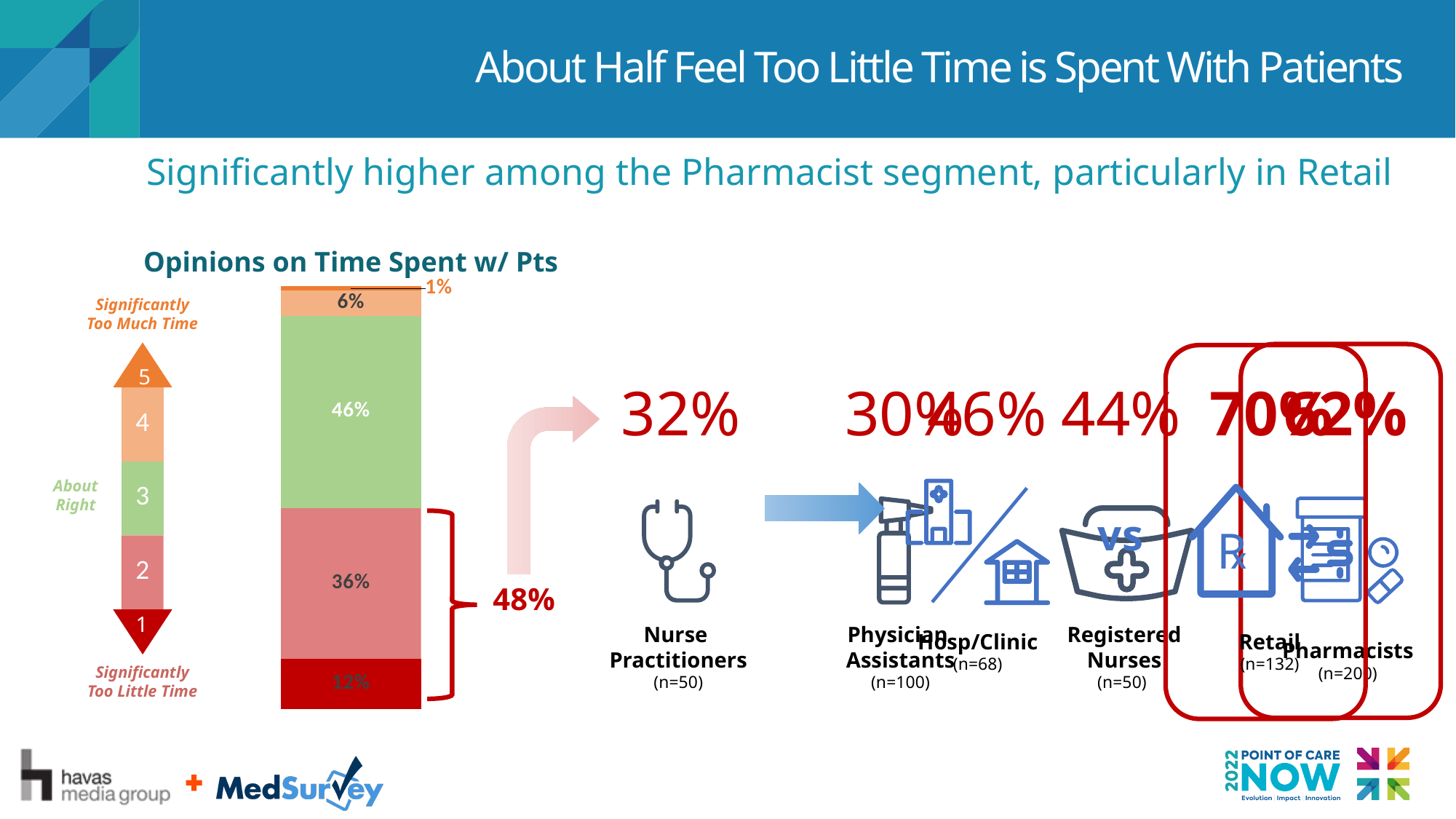
In the 'Opinions on Time Spent w/ Pts' chart, what percentage corresponds to rating 1 (Significantly Too Little Time)? 12% In the 'Opinions on Time Spent w/ Pts' chart, what percentage corresponds to rating 5 (Significantly Too Much Time)? 1% Which rating segment is the smallest in the 'Opinions on Time Spent w/ Pts' chart? Rating 5 (Significantly Too Much Time), 1% What kind of chart is 'Opinions on Time Spent w/ Pts'? Stacked bar chart In the 'Opinions on Time Spent w/ Pts' chart, what percentage corresponds to rating 3 (About Right)? 46% Which rating segment is the largest in the 'Opinions on Time Spent w/ Pts' chart? Rating 3 (About Right), 46% In the 'Opinions on Time Spent w/ Pts' chart, which is larger: the rating 2 segment or the rating 4 segment? Rating 2 In the 'Opinions on Time Spent w/ Pts' chart, what combined percentage do the bracketed bottom two segments (ratings 1 and 2) represent? 48% How many segments make up the stacked bar in the 'Opinions on Time Spent w/ Pts' chart? 5 In the 'Opinions on Time Spent w/ Pts' chart, what percentage corresponds to rating 2? 36% In the 'Opinions on Time Spent w/ Pts' chart, what is the difference between the rating 2 segment and the rating 1 segment? 24 percentage points In the 'Opinions on Time Spent w/ Pts' chart, what percentage corresponds to rating 4? 6%